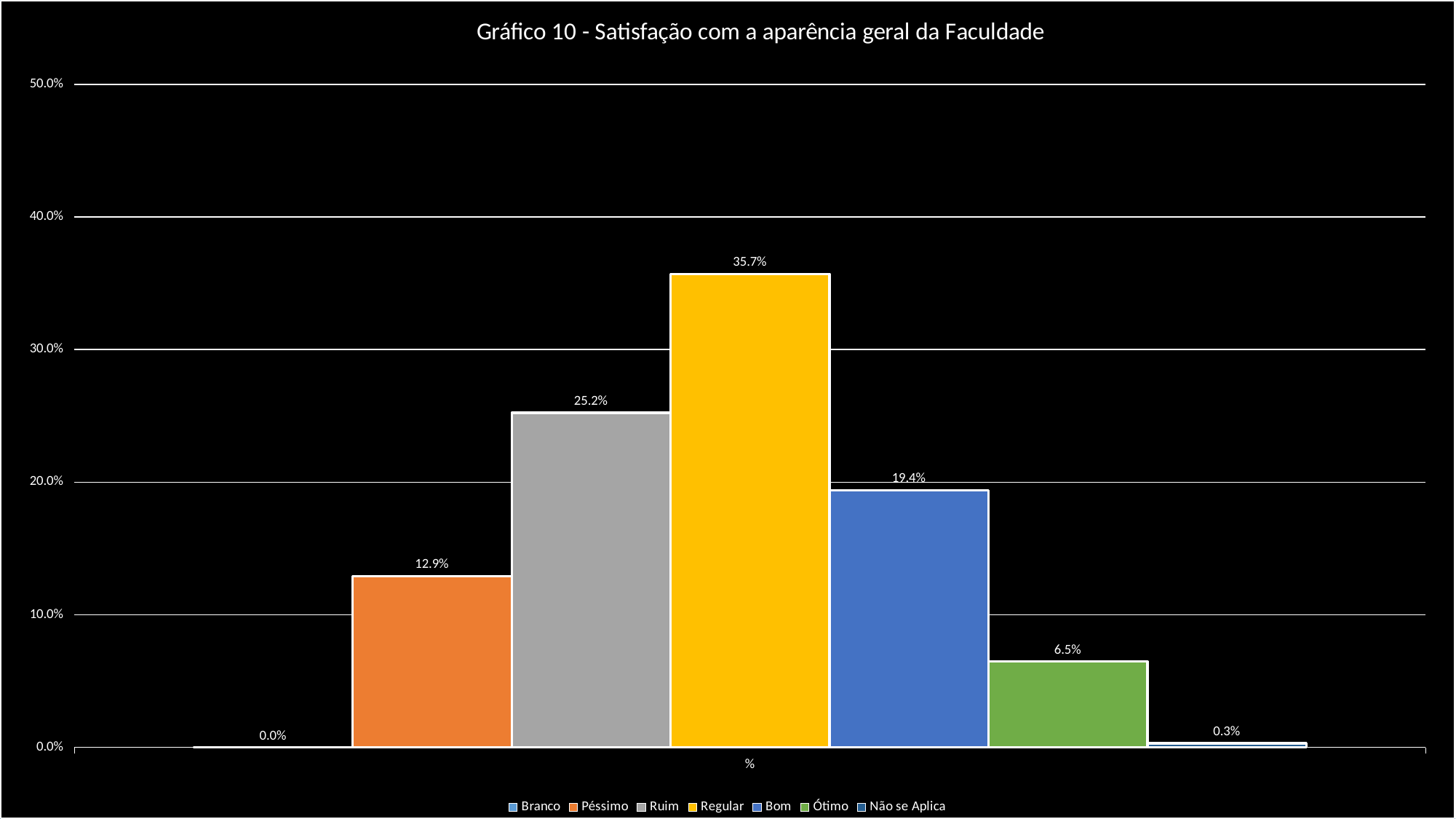
What is the value for Péssimo? 12.9% What is the value for Ótimo? 6.5% What kind of chart is shown? bar chart What is the title of the chart? Gráfico 10 - Satisfação com a aparência geral da Faculdade How many series does the legend list? 7 Is the value for Bom greater or less than 20.0%? less What is the difference between the values for Regular and Ruim? 10.5% Which series has the lowest value? Branco What is the value for Não se Aplica? 0.3% Which series has the highest value? Regular Which is larger, the value for Bom or the value for Ruim? Ruim What is the value for Regular? 35.7%